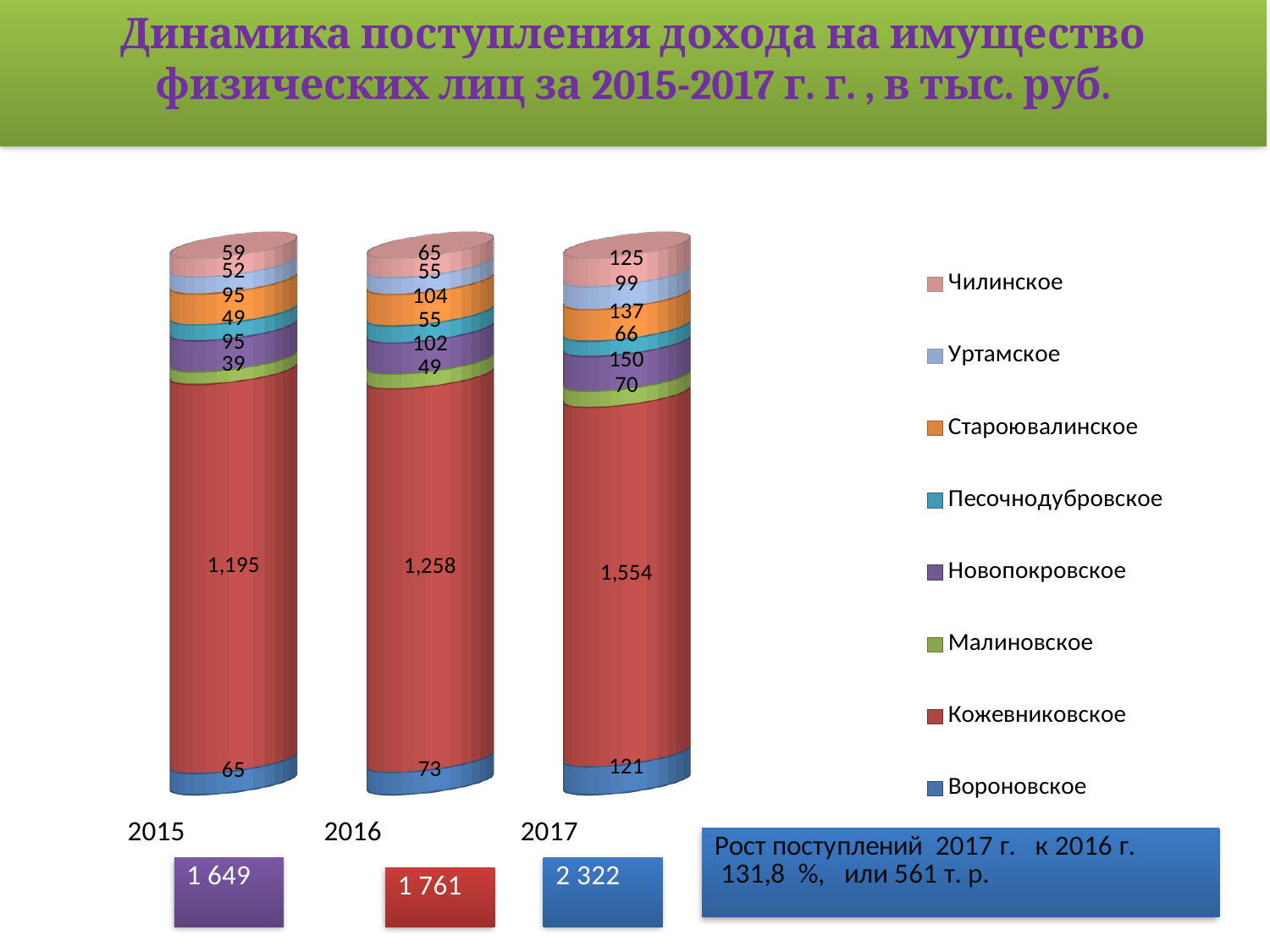
What is the value for Вороновское in 2015? 65 What is the difference between the Кожевниковское values for 2017 and 2016? 296 What kind of chart is shown on the slide? Stacked bar chart How many series does the legend list? 8 What is the value for Староювалинское in 2017? 137 Which is larger: the Чилинское value in 2017 or the Уртамское value in 2017? Чилинское Which series has the highest value in 2016? Кожевниковское What is the total of the stacked bar for 2017? 2 322 How many years are shown on the x axis? 3 Which series has the lowest value in 2015? Малиновское What is the value for Кожевниковское in 2017? 1,554 What is the value for Новопокровское in 2016? 102